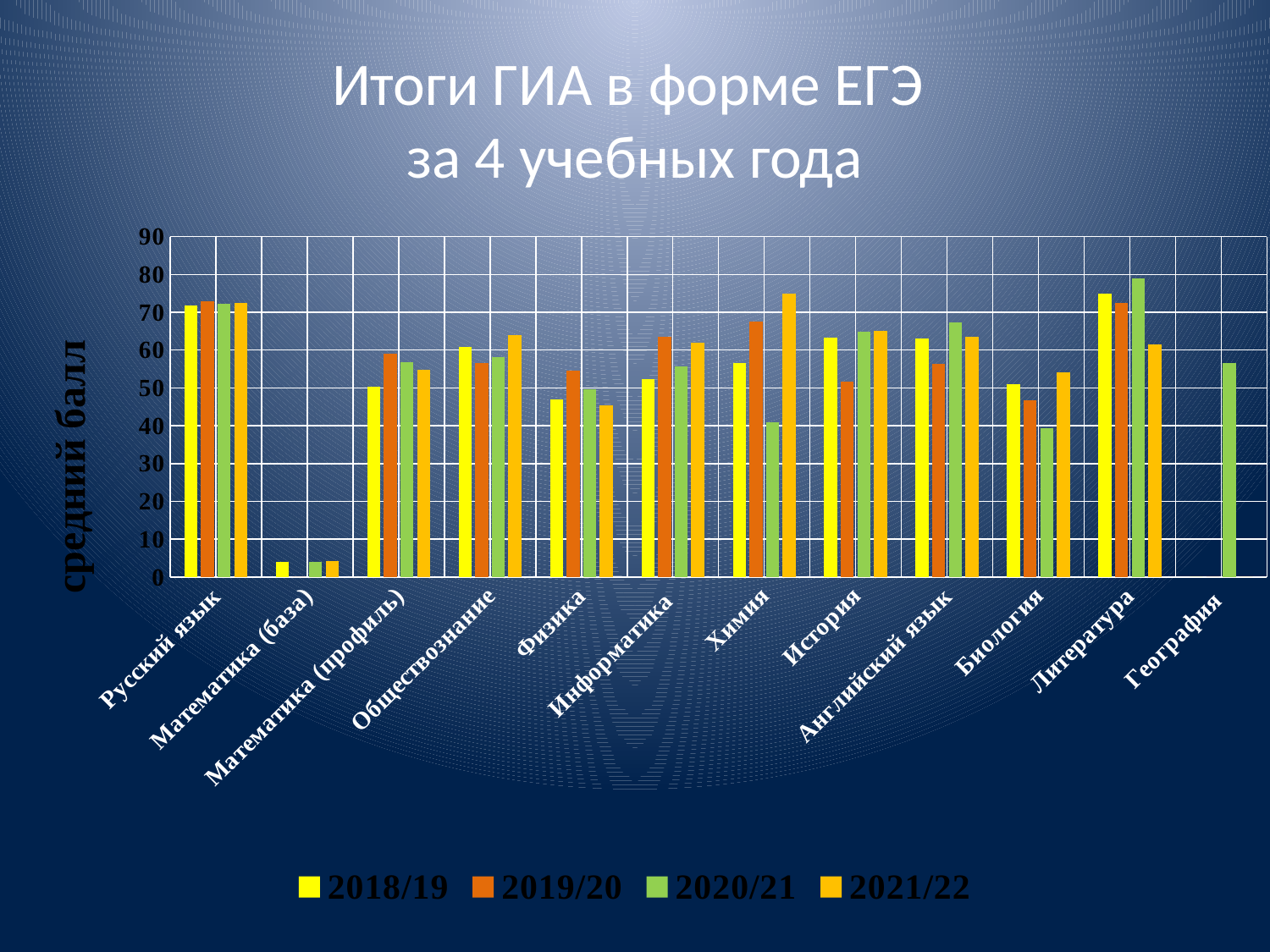
Is the value for Химия in 2021/22 greater or less than 70? greater Is the value for Математика (база) in 2018/19 greater or less than 10? less What is the label of the vertical axis? средний балл Which subject has the lowest values across all years? Математика (база) Is the value for Русский язык in 2018/19 greater or less than 60? greater How many subject categories are shown along the x axis? 12 What kind of chart is shown on the slide? bar chart How many series does the legend list? 4 For Биология, which is larger: the 2018/19 value or the 2020/21 value? 2018/19 For Химия, which is larger: the 2020/21 value or the 2021/22 value? 2021/22